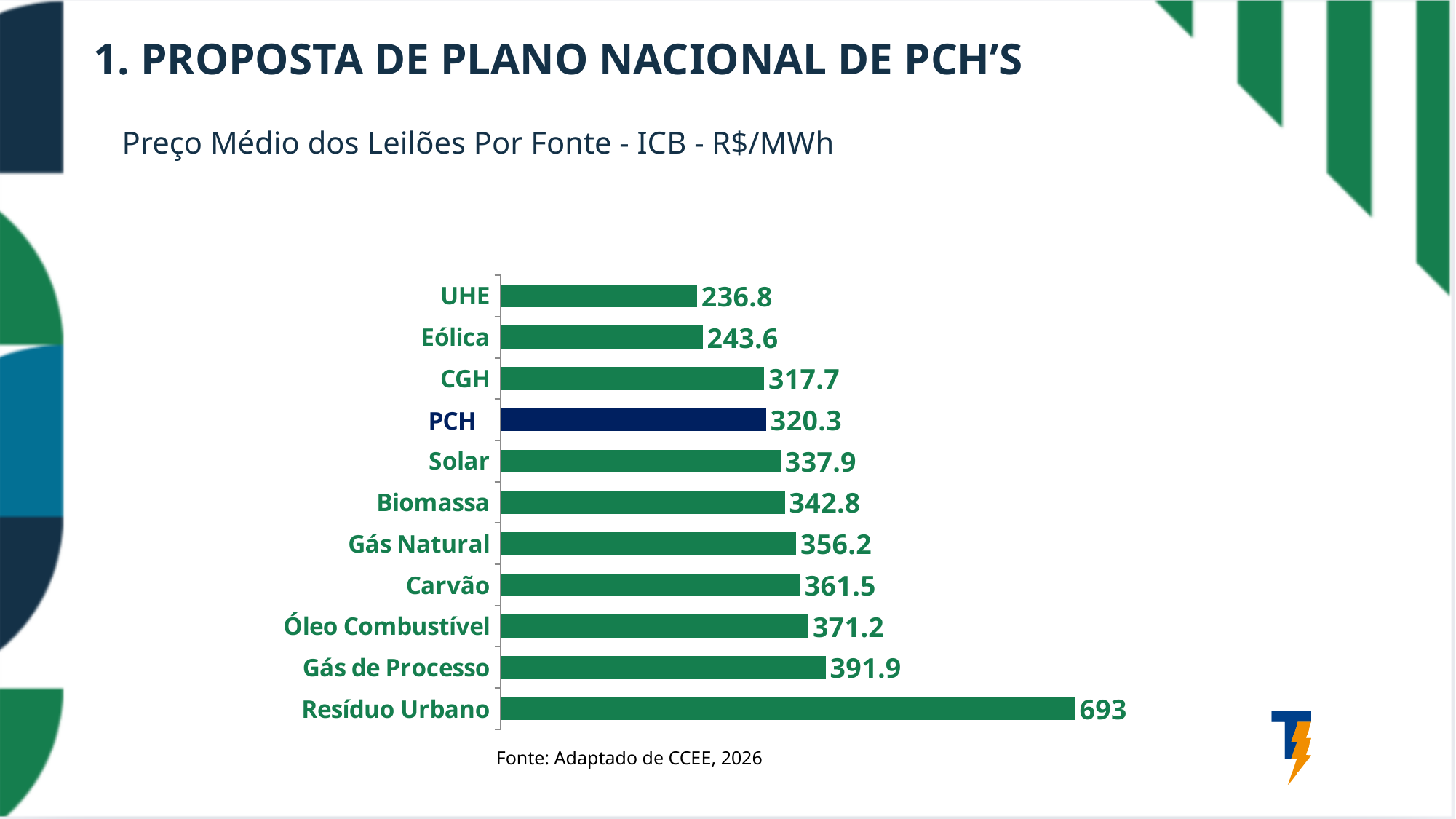
What is the value for Resíduo Urbano? 693 What is the value for PCH? 320.3 How many categories are shown in the chart? 11 Which bar is shown in a different colour (dark blue) from the others? PCH Which is larger, the value for Carvão or the value for Biomassa? Carvão What is the value for Eólica? 243.6 What is the difference between the values for Gás de Processo and Óleo Combustível? 20.7 Which is larger, the value for Solar or the value for CGH? Solar What is the difference between the values for PCH and UHE? 83.5 Which category has the lowest value? UHE Which category has the highest value? Resíduo Urbano What kind of chart is shown on the slide? Bar chart